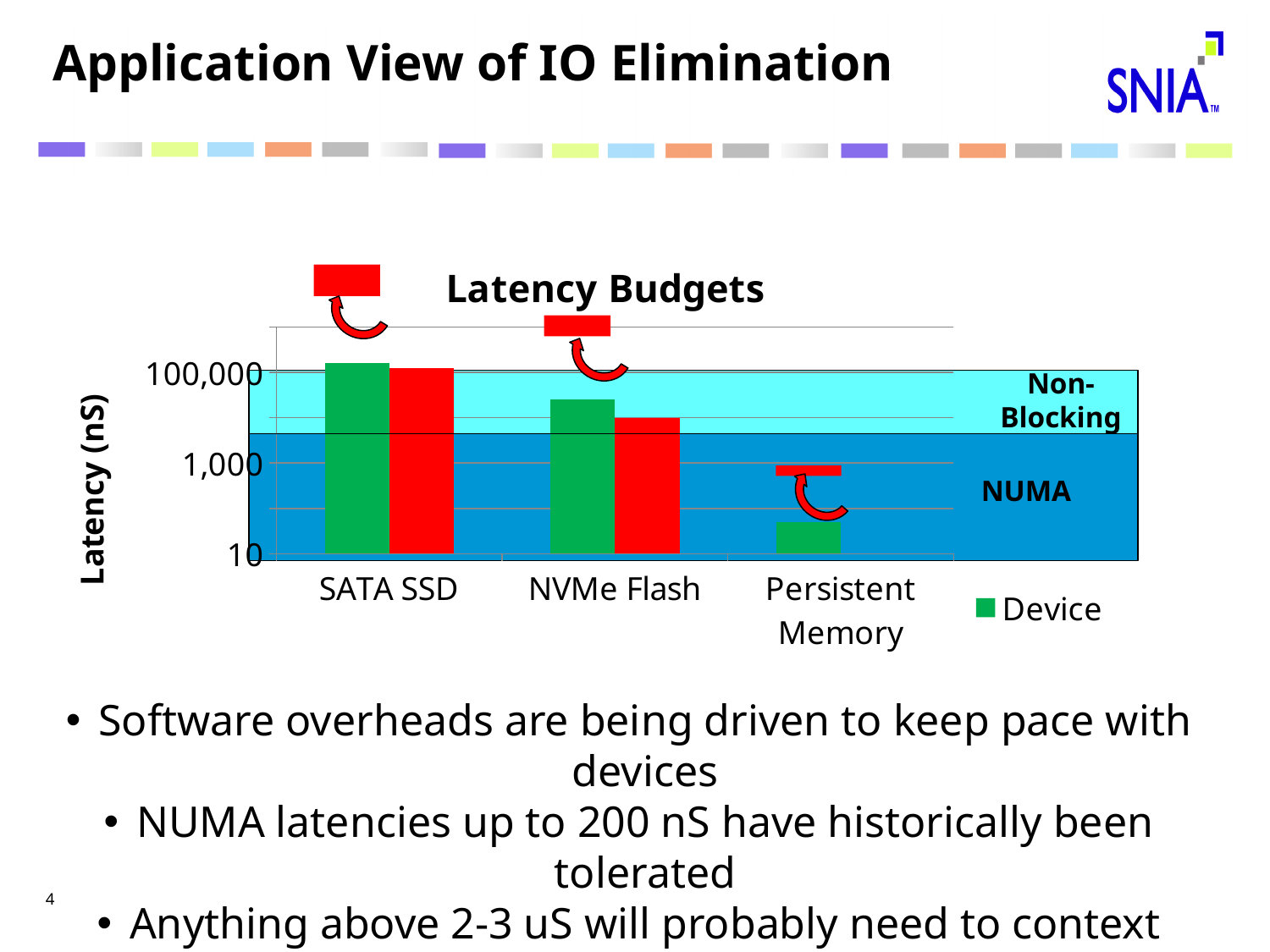
Which category has the lowest Device latency in the chart? Persistent Memory Is the Device latency for Persistent Memory greater or less than 1,000 nS? less What is the label of the y axis of the chart? Latency (nS) What is the title of the chart? Latency Budgets How many categories are shown on the x axis of the chart? 3 Which category has the highest Device latency in the chart? SATA SSD What kind of chart is shown on the slide? bar chart Which has a larger Device latency, NVMe Flash or Persistent Memory? NVMe Flash Is the Device latency for NVMe Flash greater or less than 1,000 nS? greater Which has a larger Device latency, SATA SSD or NVMe Flash? SATA SSD Is the Device latency for NVMe Flash greater or less than 100,000 nS? less Do the Device latency values rise or fall from SATA SSD to Persistent Memory along the x axis? fall